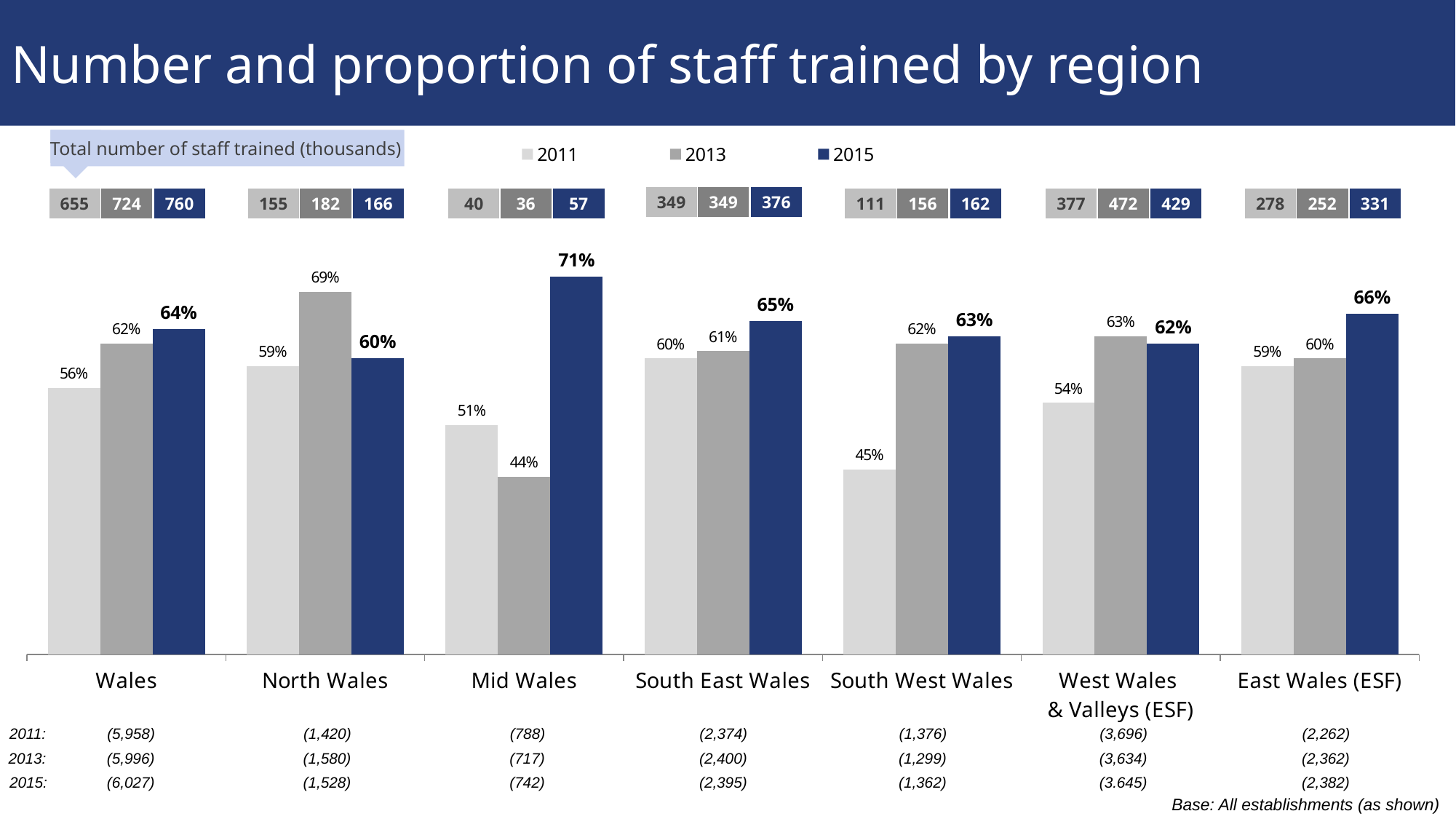
How many series does the legend list? 3 How many regions are shown on the x axis of the chart? 7 What proportion of staff were trained in Mid Wales in 2015? 71% What proportion of staff were trained in South West Wales in 2011? 45% What was the total number of staff trained (thousands) in Wales in 2015? 760 Which region had the highest proportion of staff trained in 2015? Mid Wales Which region had the lowest proportion of staff trained in 2013? Mid Wales Which year is represented by the dark blue bars in the legend? 2015 Did the proportion of staff trained in East Wales (ESF) rise or fall from 2011 to 2015? Rise What is the difference in percentage points between the 2015 and 2011 proportions of staff trained in South West Wales? 18 Which is larger: the 2013 proportion of staff trained in North Wales or in West Wales & Valleys (ESF)? North Wales What kind of chart is shown on the slide? Bar chart